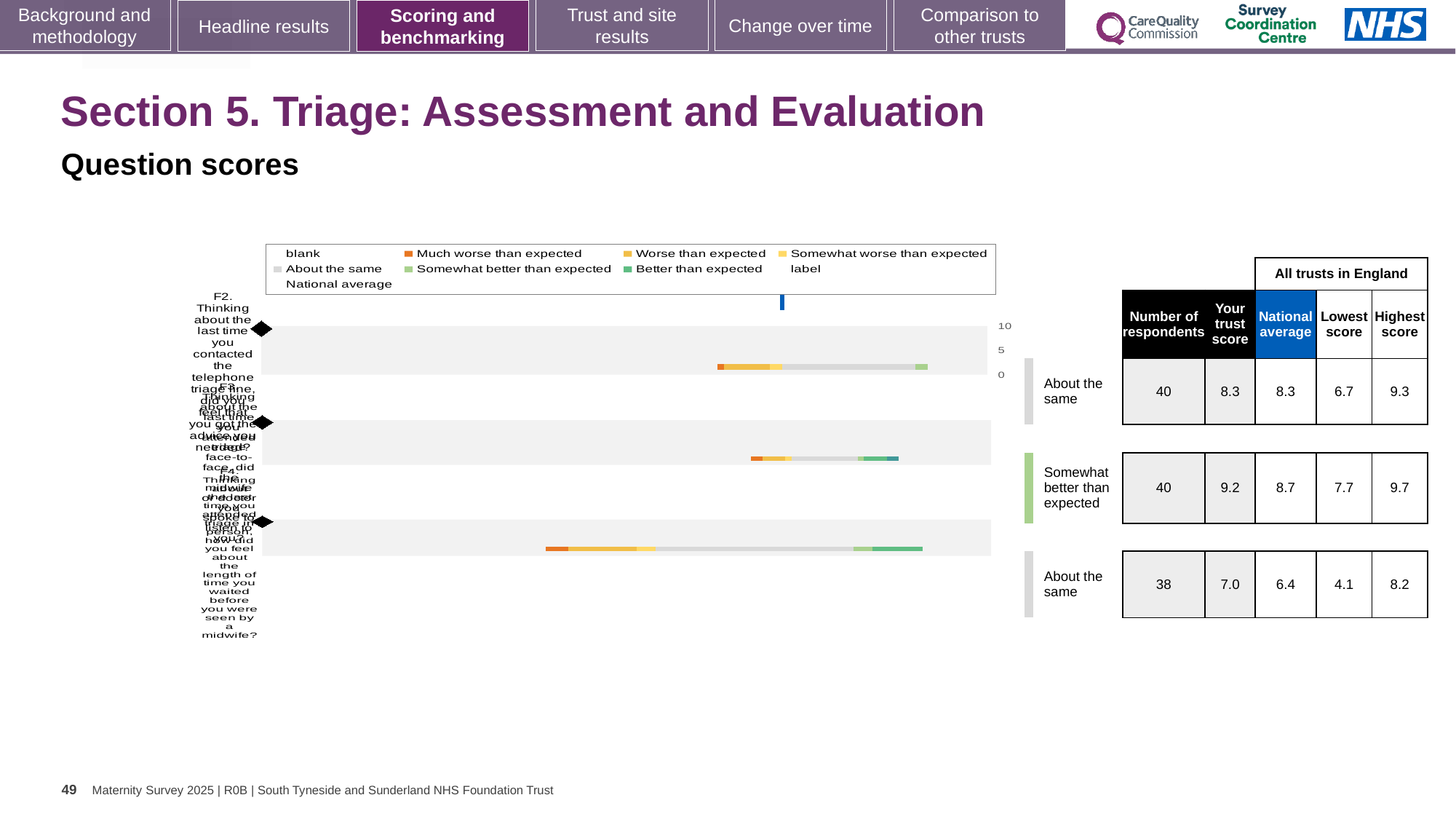
What kind of chart is shown on the slide? bar chart In the table beside the chart, what is 'Your trust score' for the second row (Somewhat better than expected)? 9.2 In the table beside the chart, which row has the lowest 'Your trust score'? the third row (7.0) In the table beside the chart, what is the highest score for the second row (Somewhat better than expected)? 9.7 What colour does the legend use for 'Much worse than expected'? orange In the table beside the chart, what is the national average for the third row? 6.4 In the table beside the chart, what is the difference between 'Your trust score' and the national average for the second row? 0.5 In the table beside the chart, for the second row, which is larger: 'Your trust score' or the national average? Your trust score How many question bars (categories) are plotted in the chart? 3 In the table beside the chart, what is the number of respondents for the first row? 40 Which legend entry is shown in light grey? About the same How many entries does the chart's legend list? 9